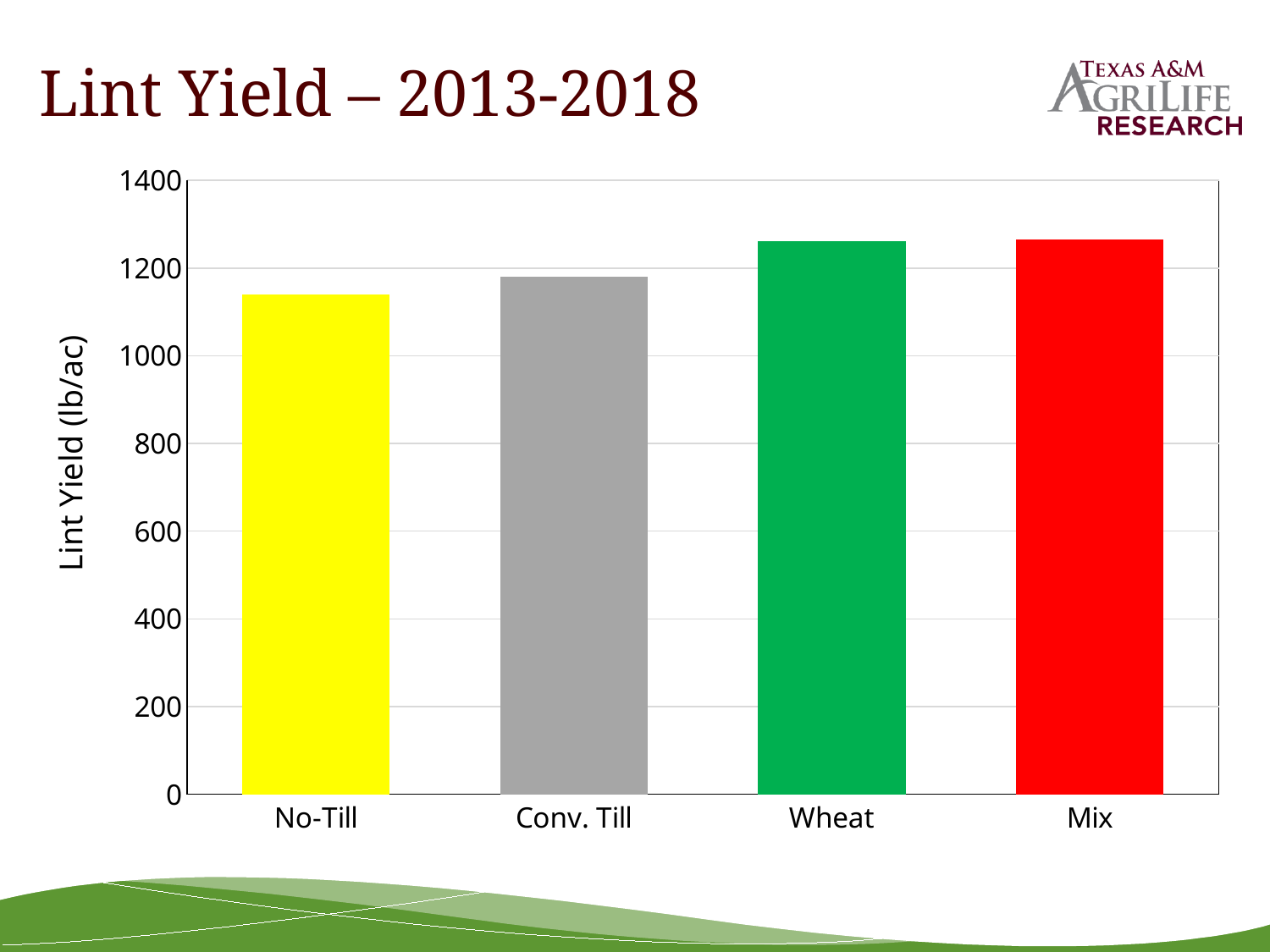
What colour is the bar for No-Till? yellow Which has a higher lint yield, Conv. Till or Mix? Mix Is the value for No-Till greater or less than 1000? greater How many categories are shown on the x axis of the chart? 4 Is the value for Wheat greater or less than 1200? greater Is the value for Conv. Till greater or less than 1000? greater Which category has the lowest lint yield? No-Till What type of chart is shown on the slide? bar chart Which has a higher lint yield, No-Till or Wheat? Wheat What is the label on the y axis of the chart? Lint Yield (lb/ac)